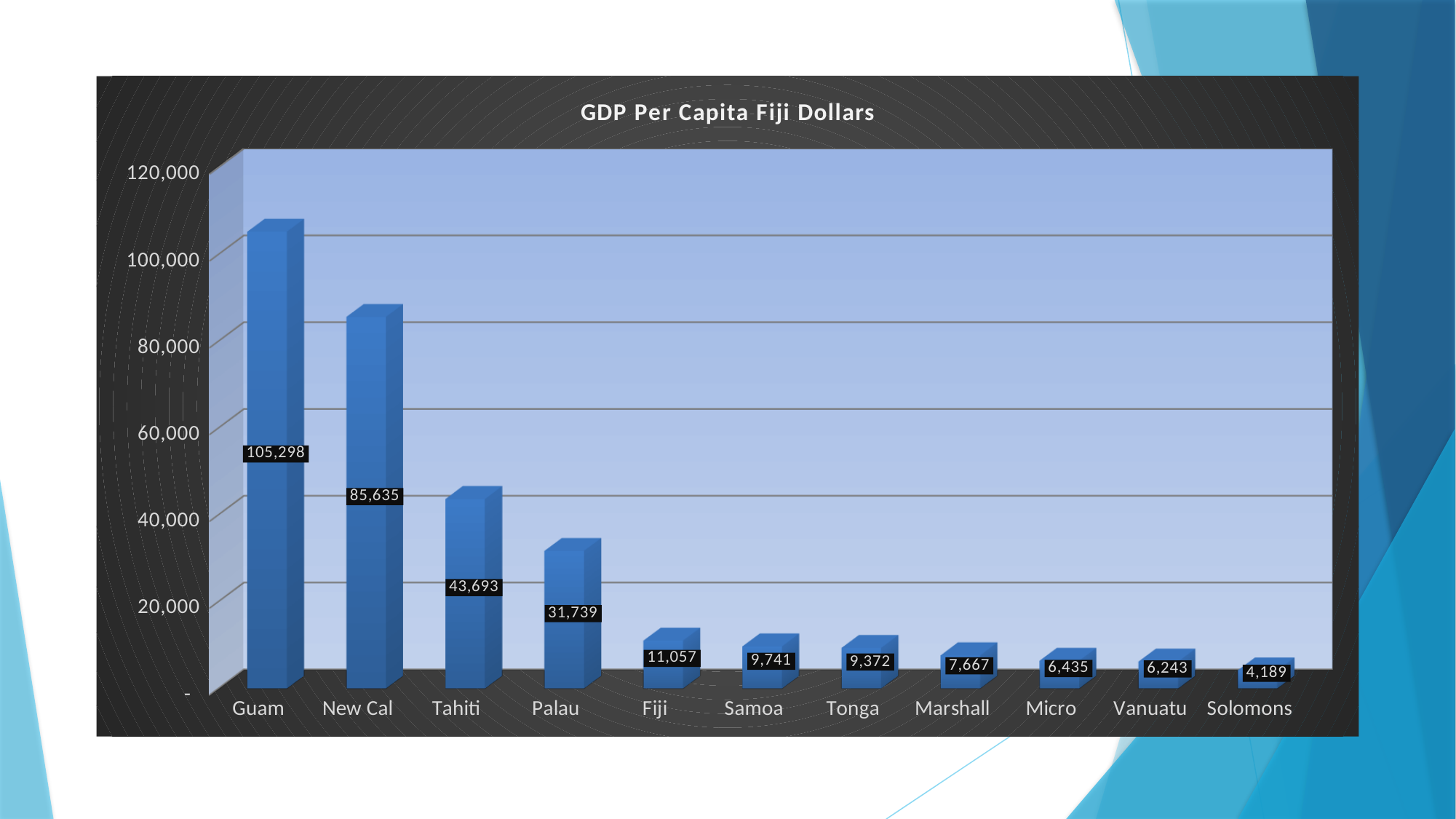
Which country has the highest GDP per capita? Guam How many countries are shown in the chart? 11 What is the GDP per capita for Guam? 105,298 What is the GDP per capita for Solomons? 4,189 What kind of chart is shown on the slide? Bar chart Which country has the lowest GDP per capita? Solomons What is the difference in GDP per capita between Tahiti and Palau? 11,954 Which has a higher GDP per capita, Fiji or Samoa? Fiji What is the difference in GDP per capita between Guam and New Cal? 19,663 Do the values rise or fall from left to right across the x axis? Fall Is the GDP per capita for New Cal greater or less than 80,000? greater What is the GDP per capita for Tahiti? 43,693